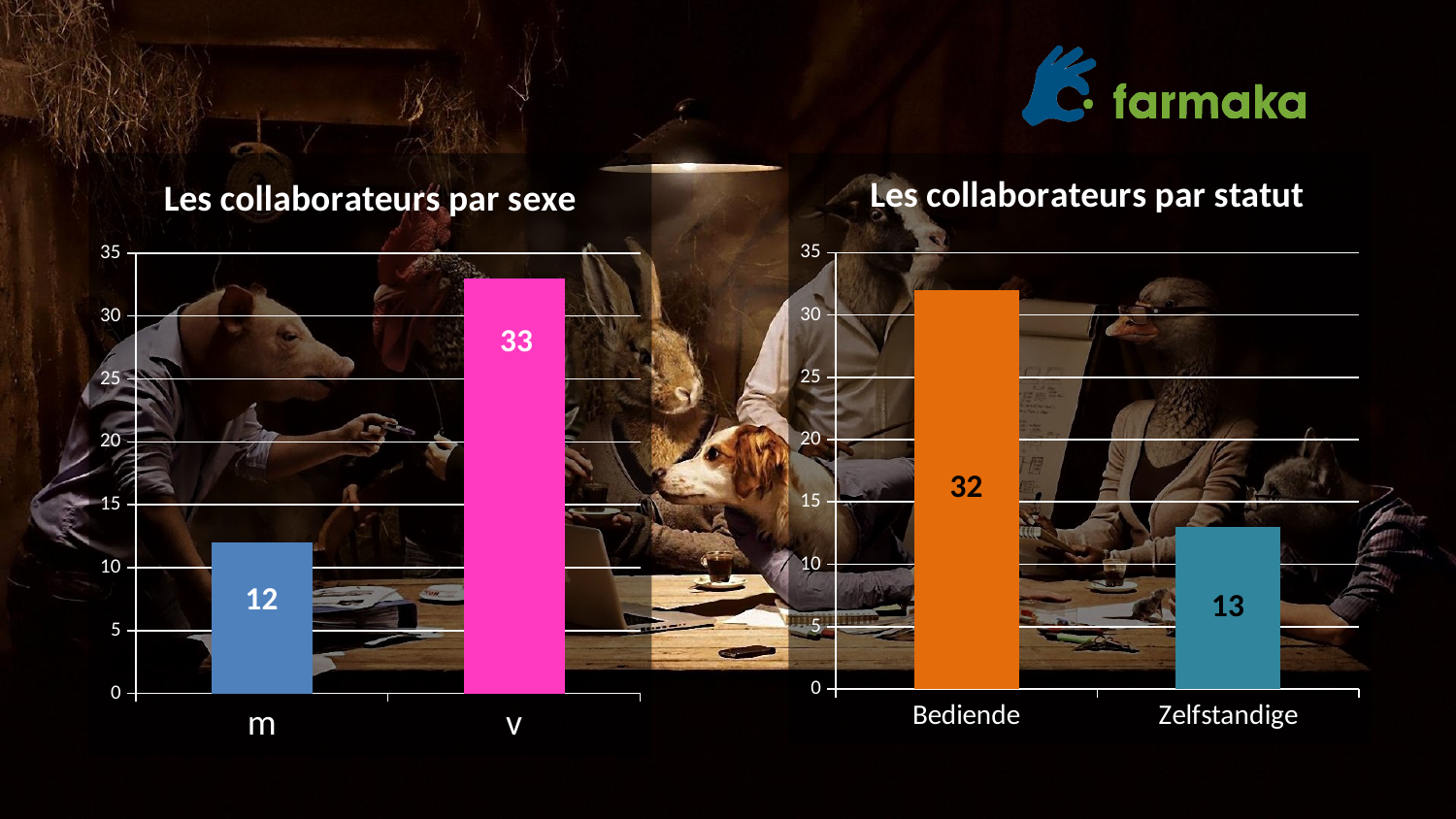
In the chart 'Les collaborateurs par statut', which is larger, Bediende or Zelfstandige? Bediende In the chart 'Les collaborateurs par sexe', what is the difference between the values for v and m? 21 In the chart 'Les collaborateurs par statut', which category has the lowest value? Zelfstandige In the chart 'Les collaborateurs par sexe', which category has the highest value? v What kind of chart is 'Les collaborateurs par statut'? bar chart In the chart 'Les collaborateurs par statut', what is the value for Zelfstandige? 13 In the chart 'Les collaborateurs par sexe', what is the value for v? 33 In the chart 'Les collaborateurs par sexe', what colour is the bar for v? pink In the chart 'Les collaborateurs par statut', what is the value for Bediende? 32 In the chart 'Les collaborateurs par sexe', how many categories are shown? 2 In the chart 'Les collaborateurs par sexe', what is the value for m? 12 In the chart 'Les collaborateurs par statut', what is the difference between the values for Bediende and Zelfstandige? 19